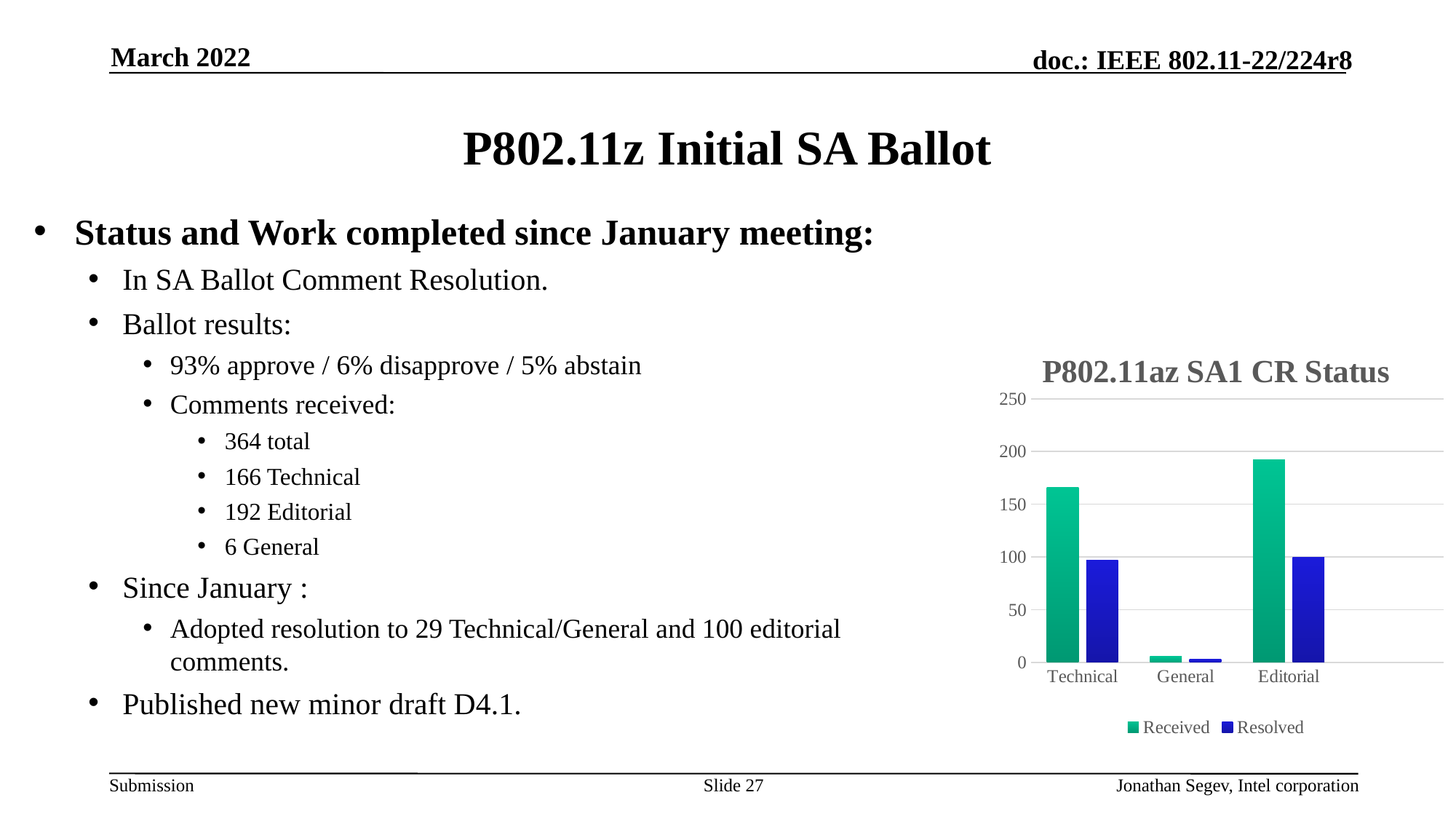
Is the Received value for Technical greater or less than 150? greater What kind of chart is shown on the slide? bar chart For Editorial, which is larger, Received or Resolved? Received Which category has the lowest Received value? General Which series is shown in green in the chart? Received How many categories are shown on the x axis of the chart? 3 Which category has the highest Received value? Editorial Is the Received value for Editorial greater or less than 200? less Is the Resolved value for Technical greater or less than 150? less Which category has the lowest Resolved value? General What is the title of the chart? P802.11az SA1 CR Status How many series does the chart legend list? 2